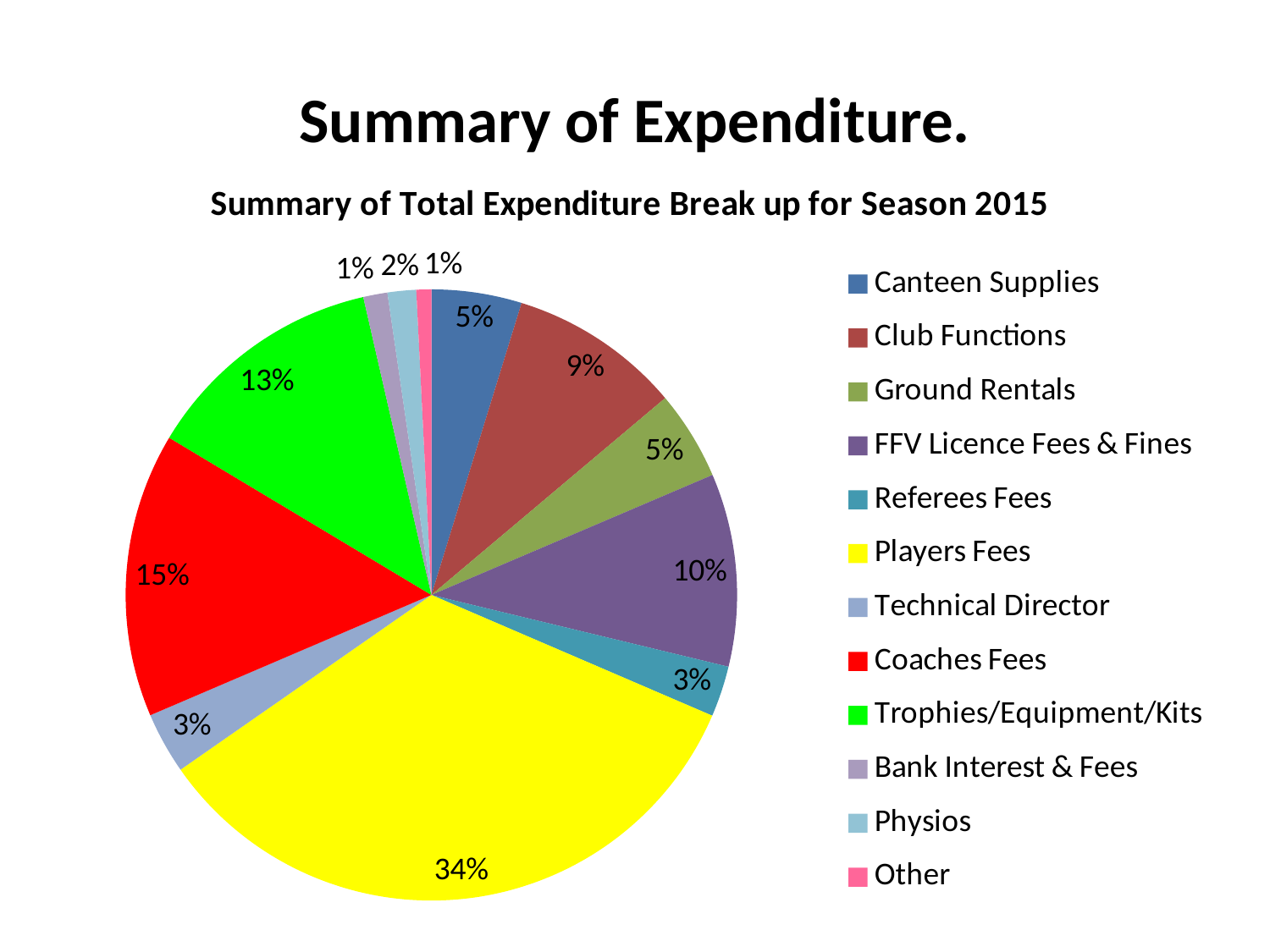
Which is larger, the share for Coaches Fees or the share for Trophies/Equipment/Kits? Coaches Fees What share of total expenditure is FFV Licence Fees & Fines? 10% What share of total expenditure is Trophies/Equipment/Kits? 13% What colour represents Players Fees in the chart? yellow What share of total expenditure is Players Fees? 34% Which category has the largest share of expenditure? Players Fees How many categories does the legend list? 12 What type of chart is shown on the slide? pie chart What is the title of the chart? Summary of Total Expenditure Break up for Season 2015 What is the difference in percentage points between Players Fees and Coaches Fees? 19